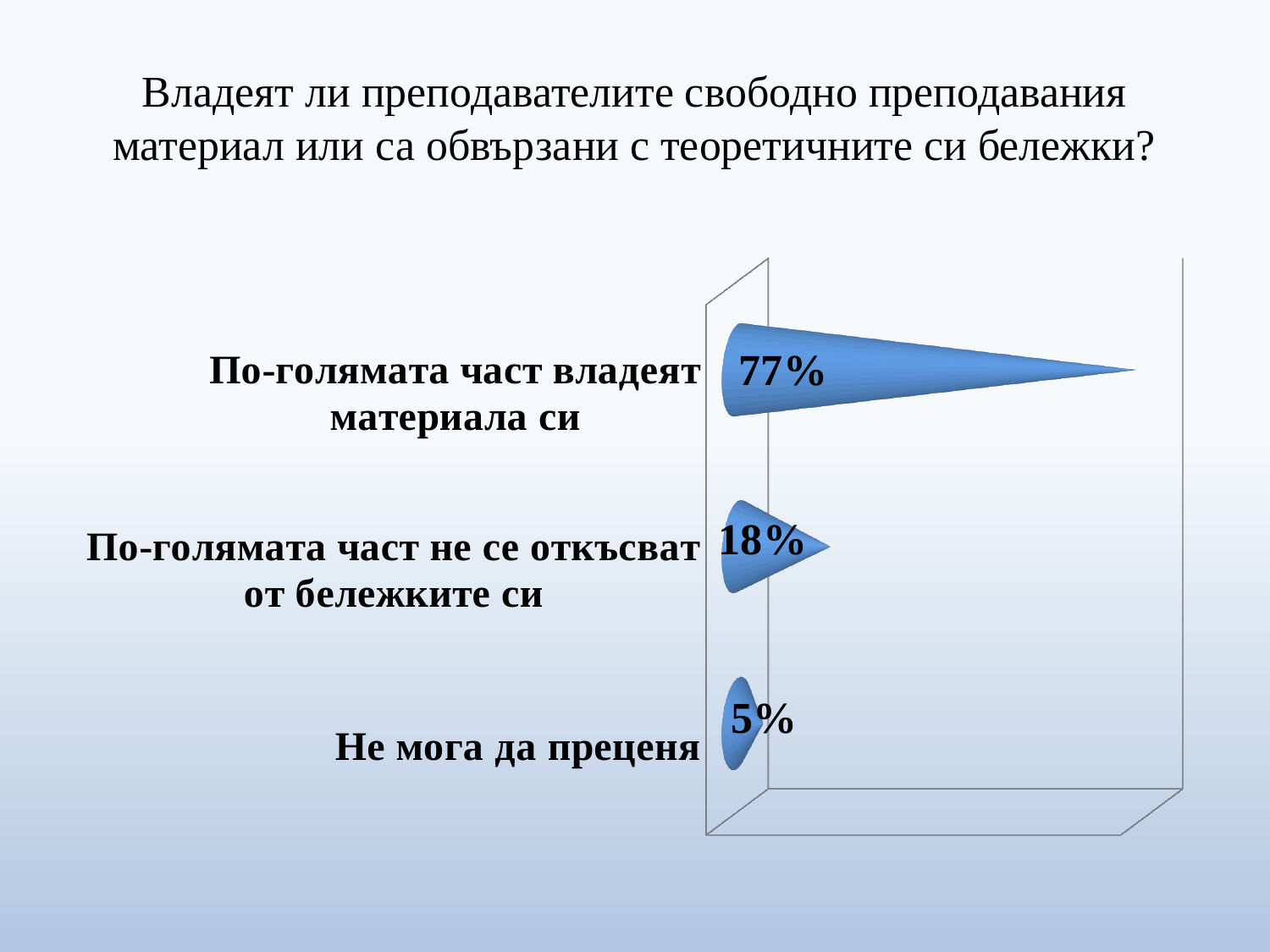
What kind of chart is shown on the slide? Bar chart What colour are the bars in the chart? Blue What is the title of the slide? Владеят ли преподавателите свободно преподавания материал или са обвързани с теоретичните си бележки? Which is larger: the value for "По-голямата част не се откъсват от бележките си" or the value for "Не мога да преценя"? По-голямата част не се откъсват от бележките си What is the difference between the values for "По-голямата част не се откъсват от бележките си" and "Не мога да преценя"? 13% What is the value for "По-голямата част не се откъсват от бележките си"? 18% Which category has the lowest value? Не мога да преценя What is the value for "Не мога да преценя"? 5% How many categories are shown in the chart? 3 What is the difference between the values for "По-голямата част владеят материала си" and "По-голямата част не се откъсват от бележките си"? 59% What is the value for "По-голямата част владеят материала си"? 77% Which category has the highest value? По-голямата част владеят материала си